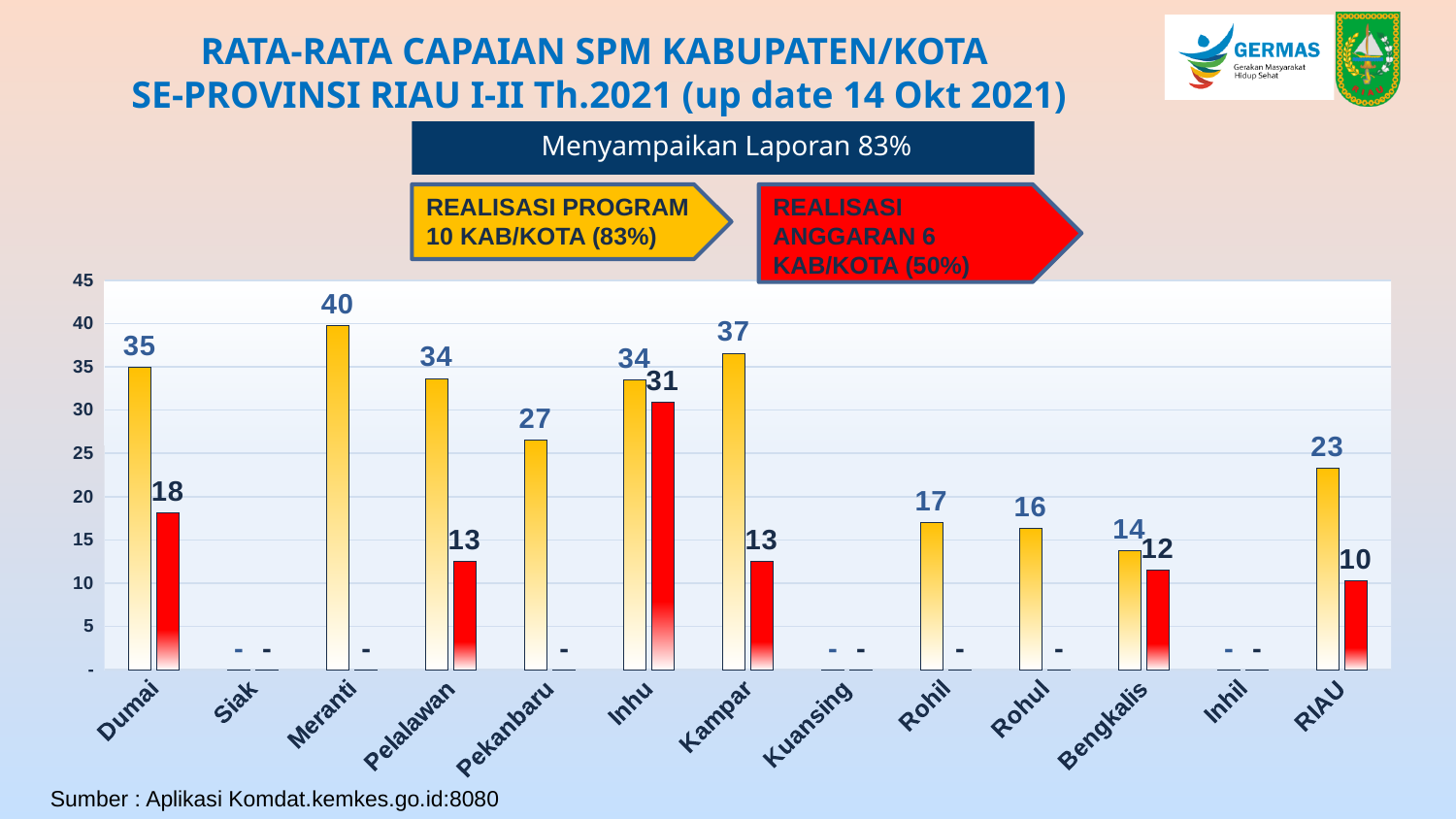
What is the value of the yellow bar for RIAU? 23 What kind of chart is shown on the slide? Bar chart What is the value of the yellow bar for Meranti? 40 What is the difference between the yellow bar for Dumai and the yellow bar for Rohul? 19 What is the value of the red bar for Inhu? 31 How many categories are shown on the x axis? 13 What is the value of the red bar for Dumai? 18 What is the value of the red bar for Bengkalis? 12 Which category has the highest yellow bar? Meranti What is the difference between the yellow bar and the red bar for Kampar? 24 Which category has the highest red bar? Inhu Which is larger, the yellow bar for Pekanbaru or the yellow bar for Rohil? Pekanbaru